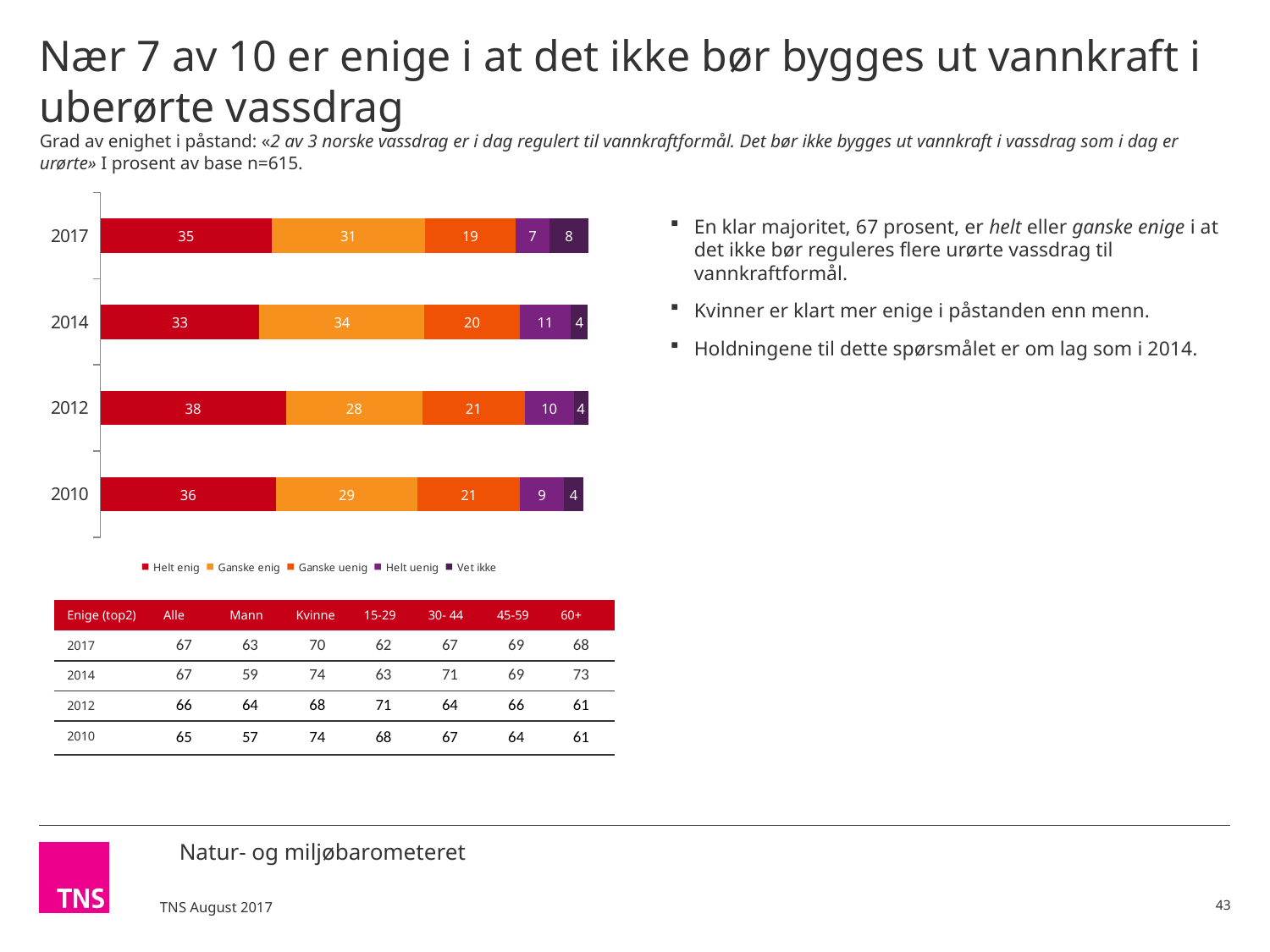
How many series does the legend list? 5 What is the value for Ganske uenig in 2010? 21 Which year has the lowest value for Helt uenig? 2017 What is the value for Helt enig in 2017? 35 How many years are shown on the chart? 4 What is the difference between the Helt uenig values for 2014 and 2017? 4 What kind of chart is shown on the slide? Stacked bar chart What is the difference between the Helt enig values for 2012 and 2010? 2 What is the value for Vet ikke in 2017? 8 What is the value for Ganske enig in 2014? 34 Which year has the highest value for Helt enig? 2012 Which year has the larger Ganske enig value, 2014 or 2017? 2014